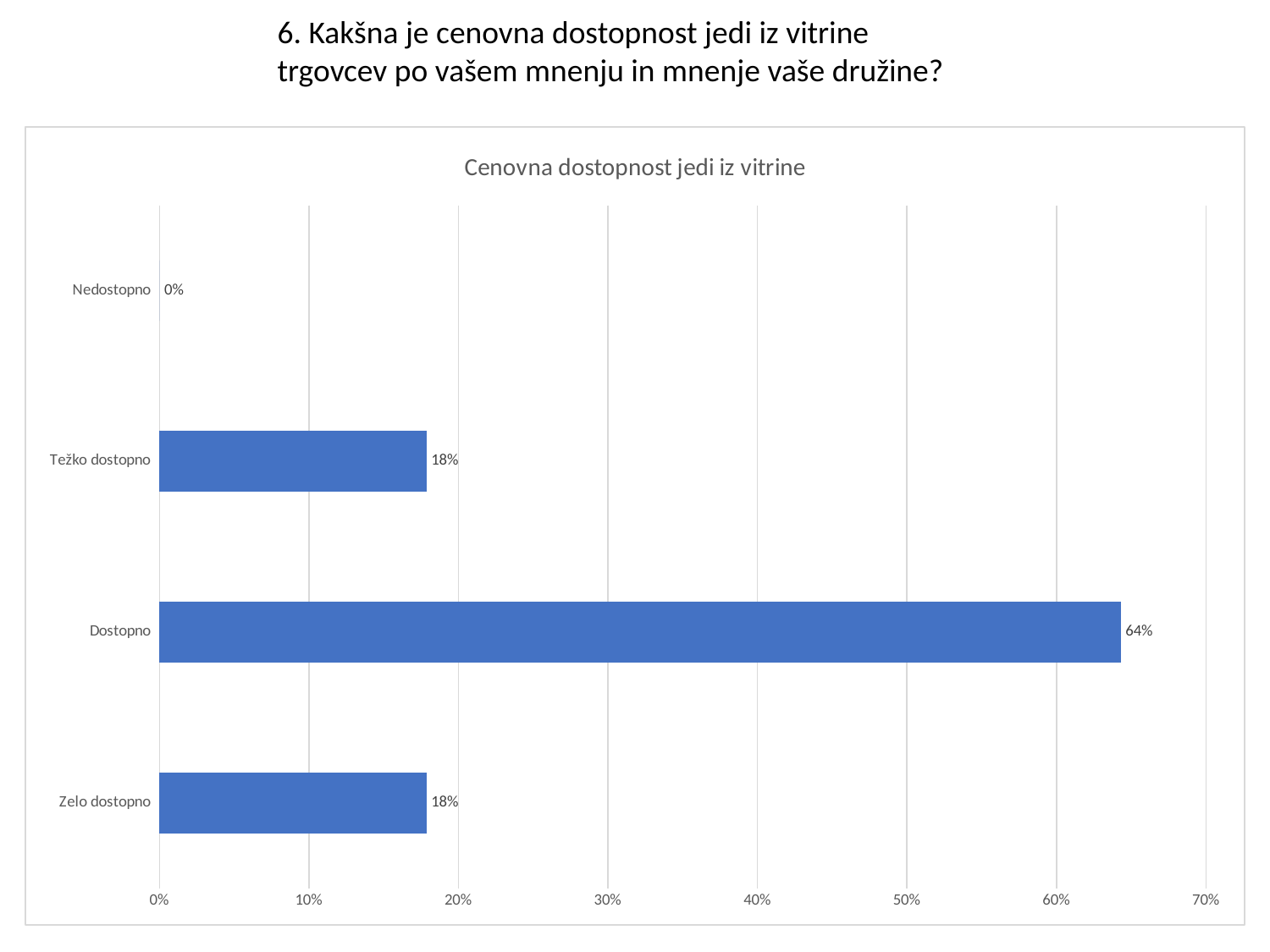
What is the value for Dostopno? 64% How many categories are shown in the chart? 4 Is the value for Dostopno greater or less than 60%? greater What is the value for Težko dostopno? 18% What kind of chart is shown on the slide? bar chart What is the difference between the values for Dostopno and Zelo dostopno? 46% What is the value for Nedostopno? 0% Which is larger, the value for Dostopno or the value for Težko dostopno? Dostopno What is the title of the chart? Cenovna dostopnost jedi iz vitrine Which category has the lowest value? Nedostopno Which category has the highest value? Dostopno What is the value for Zelo dostopno? 18%